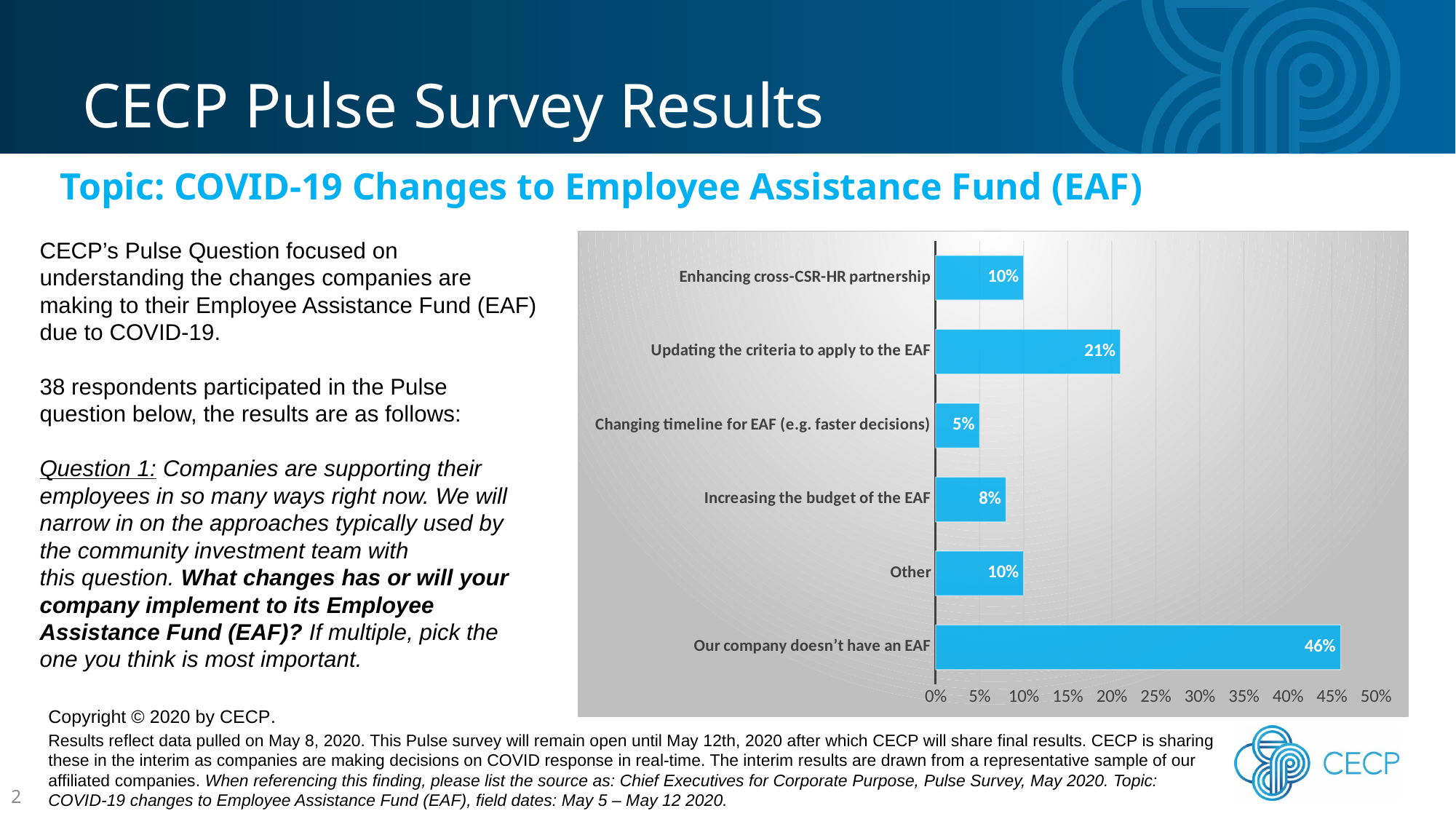
What percentage of respondents selected "Updating the criteria to apply to the EAF"? 21% Which category has the lowest value in the chart? Changing timeline for EAF (e.g. faster decisions) What is the value for "Our company doesn't have an EAF"? 46% Which is larger: "Increasing the budget of the EAF" or "Enhancing cross-CSR-HR partnership"? Enhancing cross-CSR-HR partnership What is the difference between "Our company doesn't have an EAF" and "Updating the criteria to apply to the EAF"? 25% Which category has the highest value in the chart? Our company doesn't have an EAF Is the value for "Updating the criteria to apply to the EAF" greater or less than 20%? greater What percentage is shown for "Increasing the budget of the EAF"? 8% What is the maximum value shown on the chart's percentage axis? 50% What kind of chart is shown on the slide? Bar chart What value is shown for the "Other" category? 10% How many categories are shown in the chart? 6